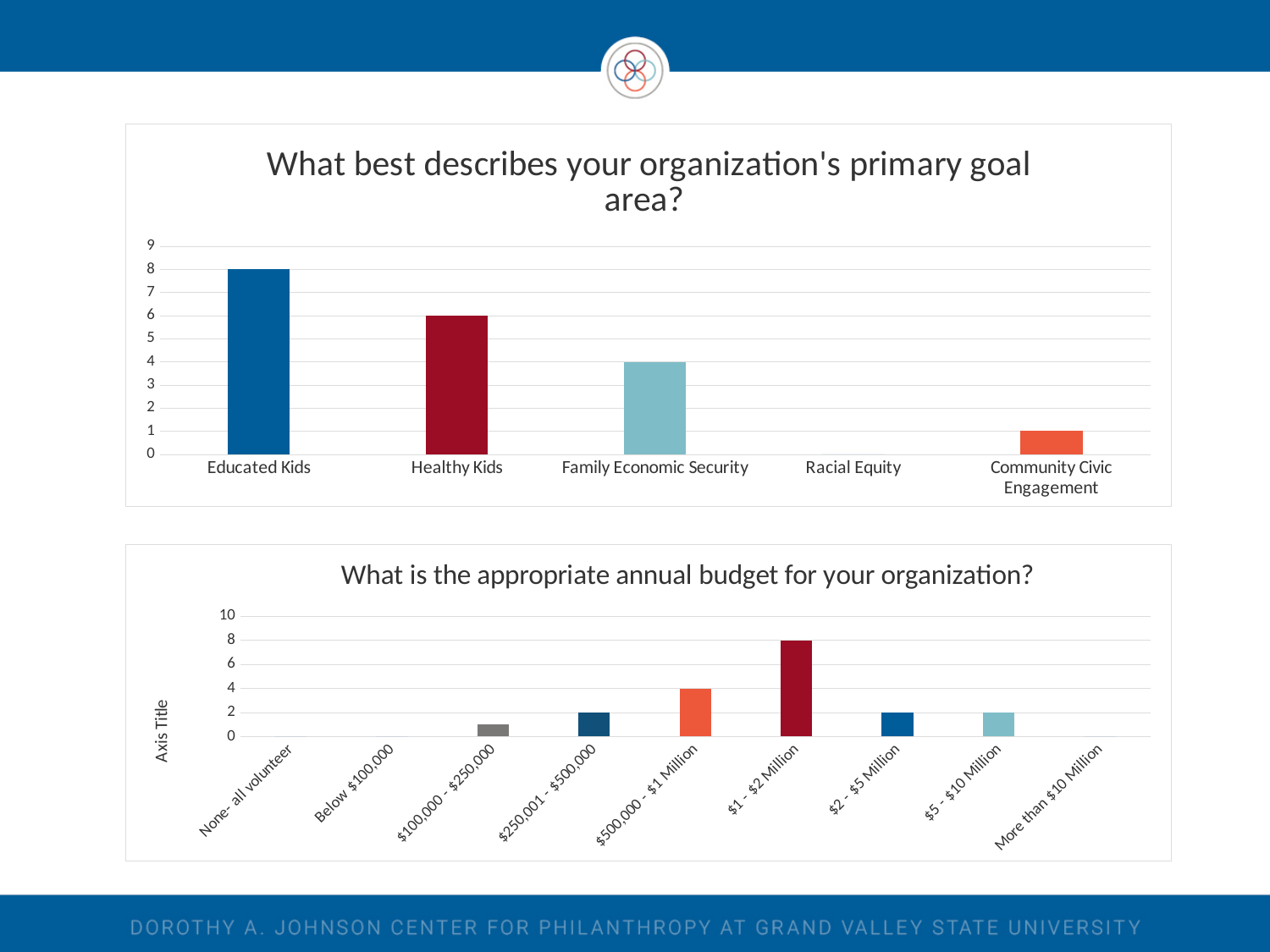
In the chart titled "What is the appropriate annual budget for your organization?", which category has the highest value? $1 - $2 Million In the chart titled "What best describes your organization's primary goal area?", what kind of chart is it? Bar chart In the chart titled "What is the appropriate annual budget for your organization?", how many categories are shown on the x axis? 9 In the chart titled "What is the appropriate annual budget for your organization?", what is the value for $1 - $2 Million? 8 In the chart titled "What best describes your organization's primary goal area?", what is the value for Educated Kids? 8 In the chart titled "What best describes your organization's primary goal area?", which category has the highest value? Educated Kids In the chart titled "What best describes your organization's primary goal area?", what is the difference between Educated Kids and Family Economic Security? 4 In the chart titled "What is the appropriate annual budget for your organization?", what is the value for $500,000 - $1 Million? 4 In the chart titled "What best describes your organization's primary goal area?", how many categories are shown on the x axis? 5 In the chart titled "What best describes your organization's primary goal area?", which category has the lowest value? Racial Equity In the chart titled "What best describes your organization's primary goal area?", what is the value for Healthy Kids? 6 In the chart titled "What is the appropriate annual budget for your organization?", is the value for $100,000 - $250,000 greater or less than 2? less